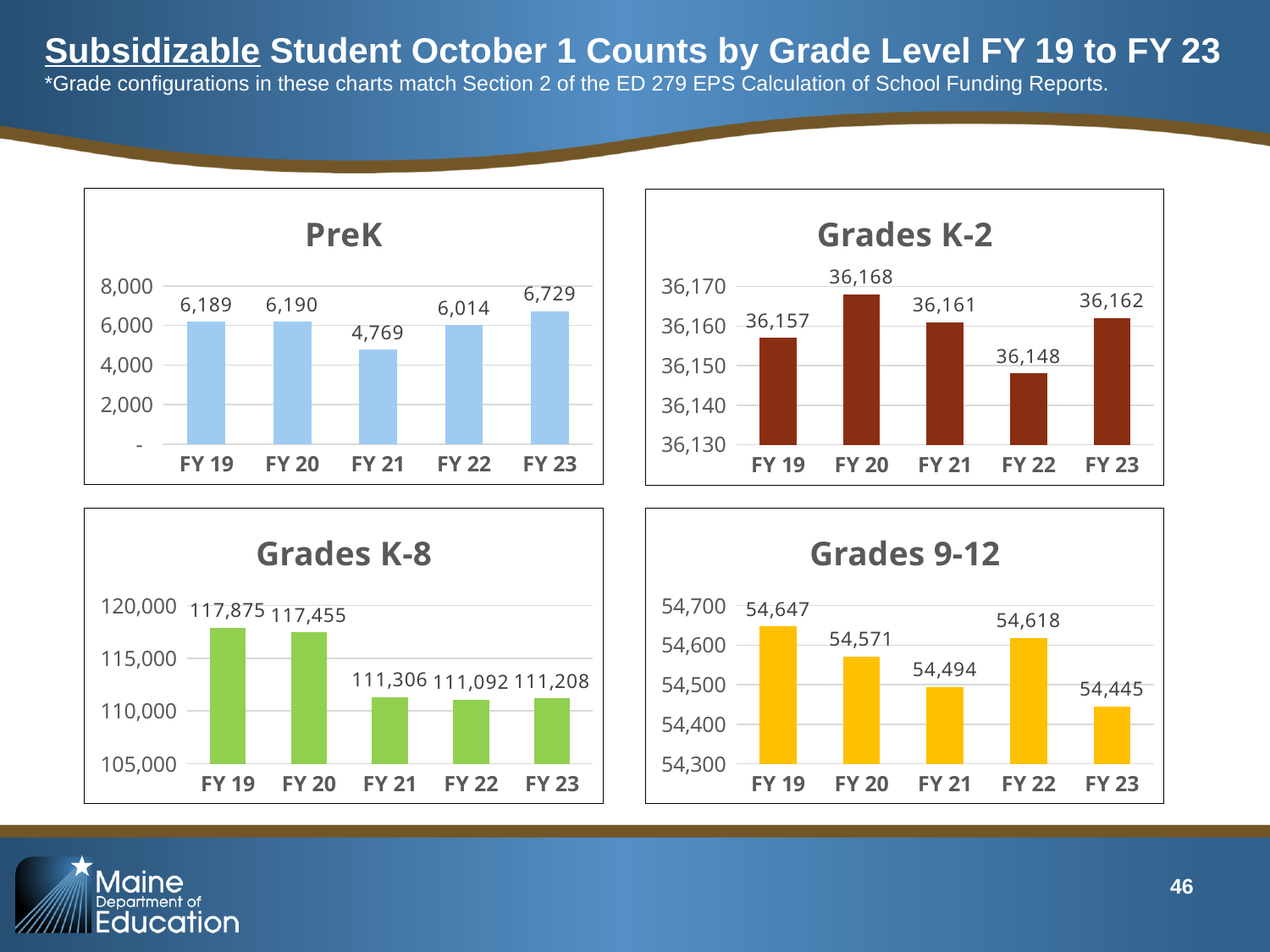
In the PreK chart, which fiscal year has the highest value? FY 23 In the Grades K-2 chart, which fiscal year has the lowest value? FY 22 How many fiscal years are shown in the Grades 9-12 chart? 5 In the Grades K-8 chart, what is the difference between the FY 19 value and the FY 23 value? 6,667 In the Grades K-2 chart, what is the difference between the FY 20 value and the FY 19 value? 11 In the PreK chart, what is the value for FY 21? 4,769 In the Grades K-8 chart, what is the value for FY 19? 117,875 In the Grades 9-12 chart, what is the value for FY 23? 54,445 In the Grades K-8 chart, which is larger, the value for FY 21 or the value for FY 22? FY 21 In the Grades 9-12 chart, which fiscal year has the highest value? FY 19 In the Grades K-2 chart, what is the value for FY 22? 36,148 What type of chart is the PreK chart? Bar chart